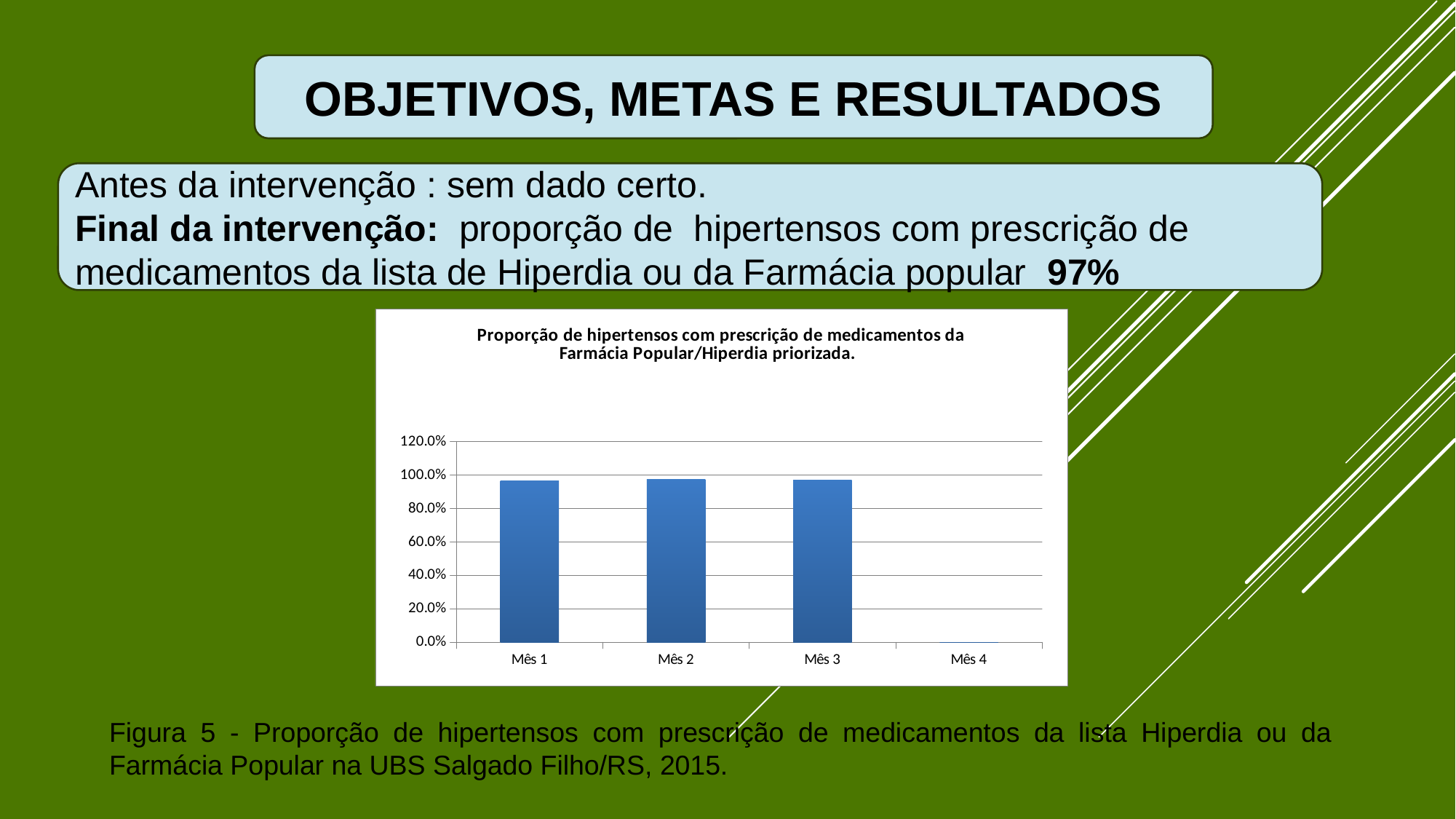
Is the value for Mês 1 greater or less than 80.0%? greater Which month has the lowest value in the chart? Mês 4 Which is larger, the value for Mês 4 or the value for Mês 1? Mês 1 What is the highest value shown on the y axis of the chart? 120.0% Is the value for Mês 2 greater or less than 100.0%? less Is the value for Mês 3 greater or less than 60.0%? greater How many categories (months) are shown on the x axis of the chart? 4 What is the title of the chart? Proporção de hipertensos com prescrição de medicamentos da Farmácia Popular/Hiperdia priorizada. What kind of chart is shown on the slide? bar chart Which is larger, the value for Mês 2 or the value for Mês 4? Mês 2